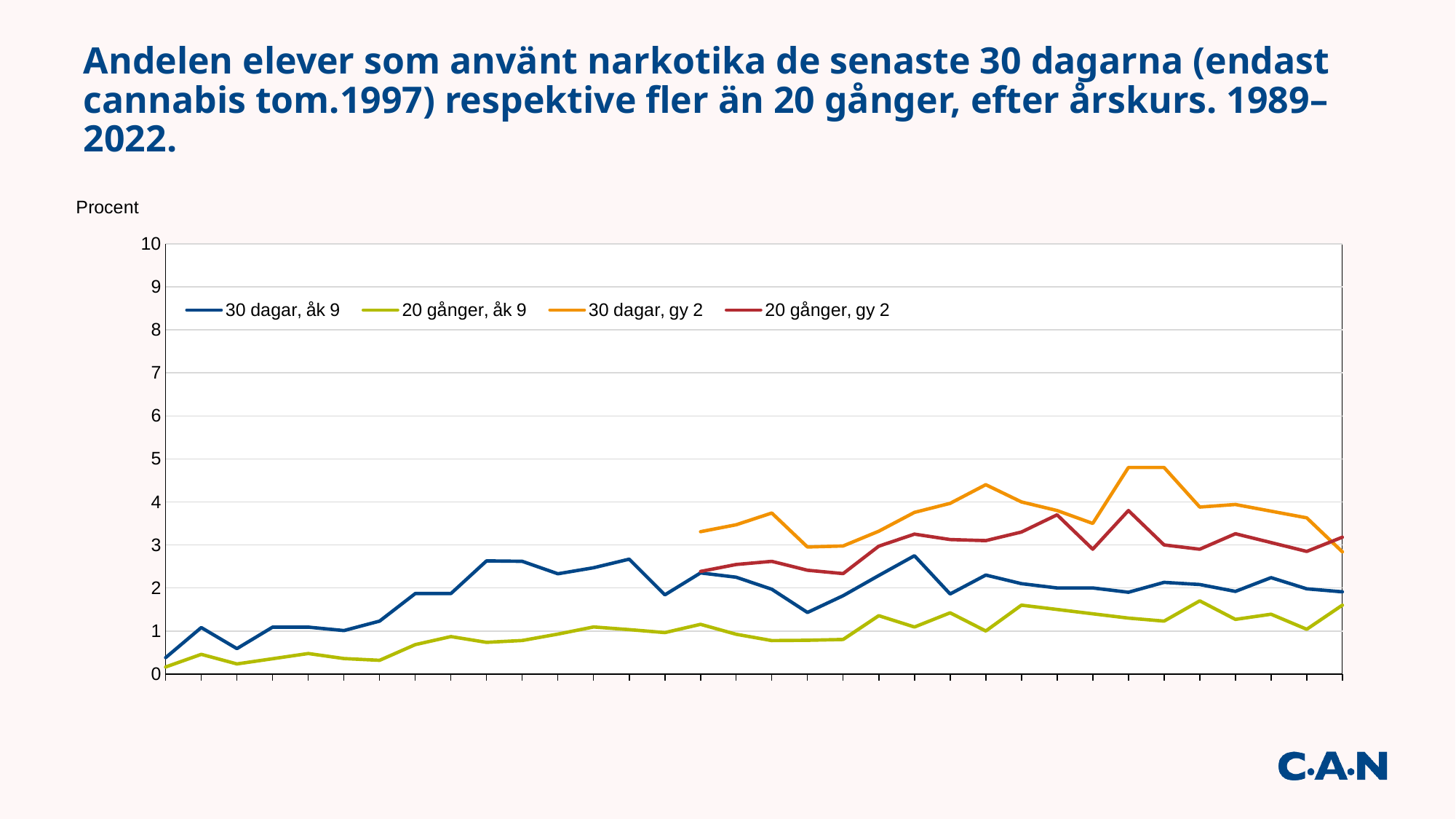
Is the highest point of the '20 gånger, åk 9' line greater or less than 2? less Which series is higher at the right end of the chart: '30 dagar, åk 9' or '20 gånger, gy 2'? 20 gånger, gy 2 Which series is plotted with the orange line? 30 dagar, gy 2 Is the highest point of the '30 dagar, åk 9' line greater or less than 3? less Which series has the highest values across the chart? 30 dagar, gy 2 Which series has the lowest values across the chart? 20 gånger, åk 9 Does any series reach a value above 5 on the chart? No Does the '30 dagar, åk 9' line overall rise or fall from the left end to the right end of the chart? rise What kind of chart is shown on the slide? line chart What is the label on the vertical axis of the chart? Procent How many series does the legend list? 4